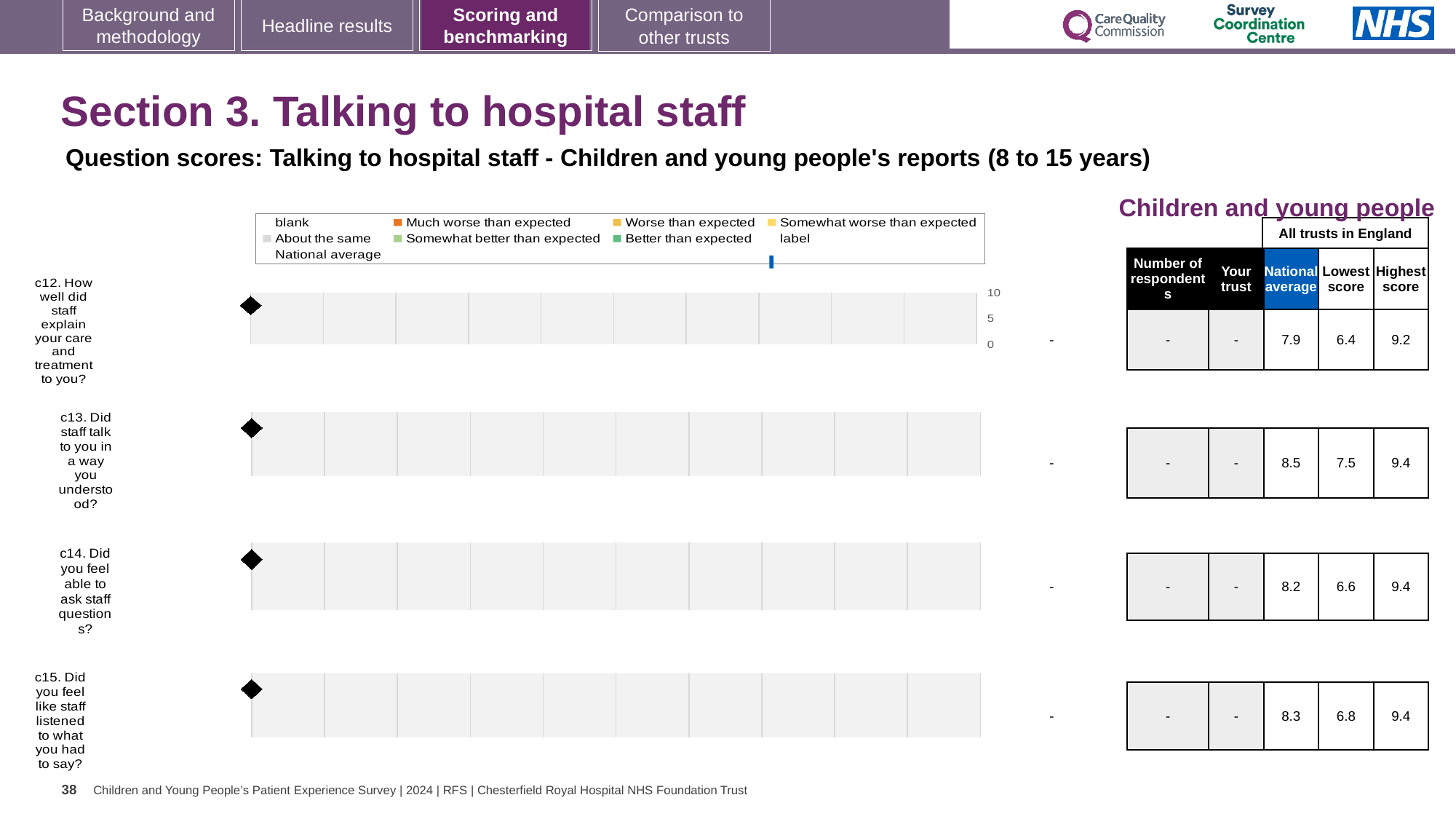
How many question charts (c12 to c15) are shown on the slide? 4 What kind of chart is used for the question scores on this slide? bar chart In the table next to the c14 chart, what is the lowest score among all trusts in England? 6.6 In the table next to the c12 chart, what is the national average score? 7.9 Is the national average for c13 or c14 larger in the tables? c13 Which question (c12 to c15) has the highest national average score in the tables? c13 In the table next to the c15 chart, what is the national average score? 8.3 What is the maximum value shown on the score axis of the c12 chart? 10 In the table next to the c13 chart, what is the highest score among all trusts in England? 9.4 What value is shown in the 'Your trust' column for c12? - For c12, what is the difference between the highest score and the lowest score in the table? 2.8 Which question (c12 to c15) has the lowest national average score in the tables? c12